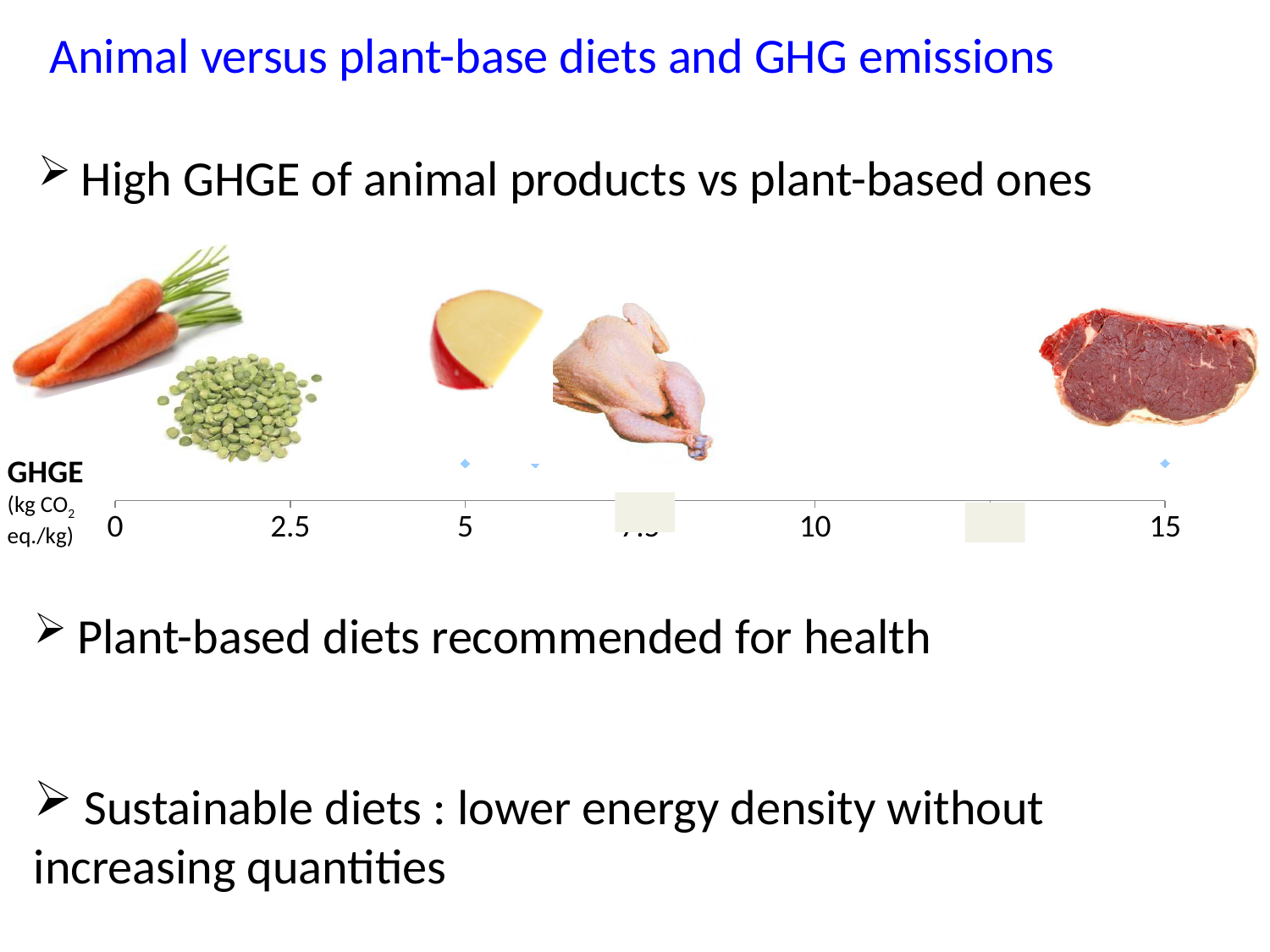
Which food pictured on the chart is placed furthest to the right on the axis? Beef What is the lowest value printed on the chart's axis? 0 Is the value for the beef (red meat) marker greater or less than 10? greater What quantity does the chart's axis measure, according to its label? GHGE Is the value for the carrots greater or less than 2.5? less What unit is shown on the chart's axis label? kg CO2 eq./kg Which has the higher GHGE on the chart, beef or chicken? Beef Which food pictured on the chart is placed furthest to the left on the axis? Carrots What is the highest value printed on the chart's axis? 15 Is the value for the cheese marker greater or less than 10? less Which has the lower GHGE on the chart, carrots or cheese? Carrots